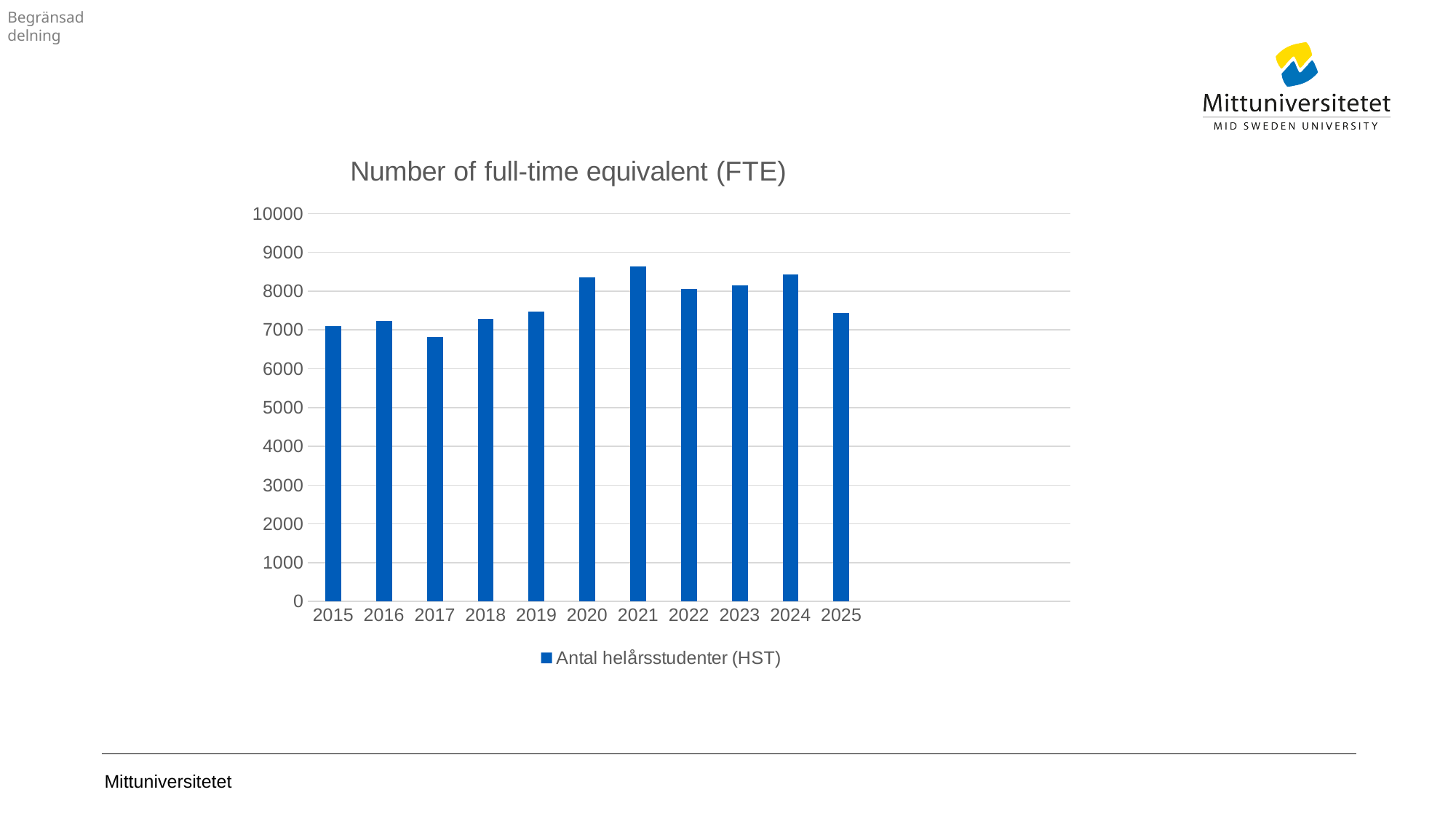
What kind of chart is shown on the slide? bar chart Is the value for 2020 greater or less than 8000? greater Is the value for 2017 greater or less than 7000? less Which is larger, the value for 2020 or the value for 2019? 2020 Do the values rise or fall from 2017 to 2021? rise Which year has the highest number of full-time equivalent students? 2021 What is the title of the chart? Number of full-time equivalent (FTE) Which year has the lowest number of full-time equivalent students? 2017 What is the legend entry for the series in the chart? Antal helårsstudenter (HST) How many years are shown on the x axis of the chart? 11 How many series does the legend list? 1 Is the value for 2021 greater or less than 9000? less